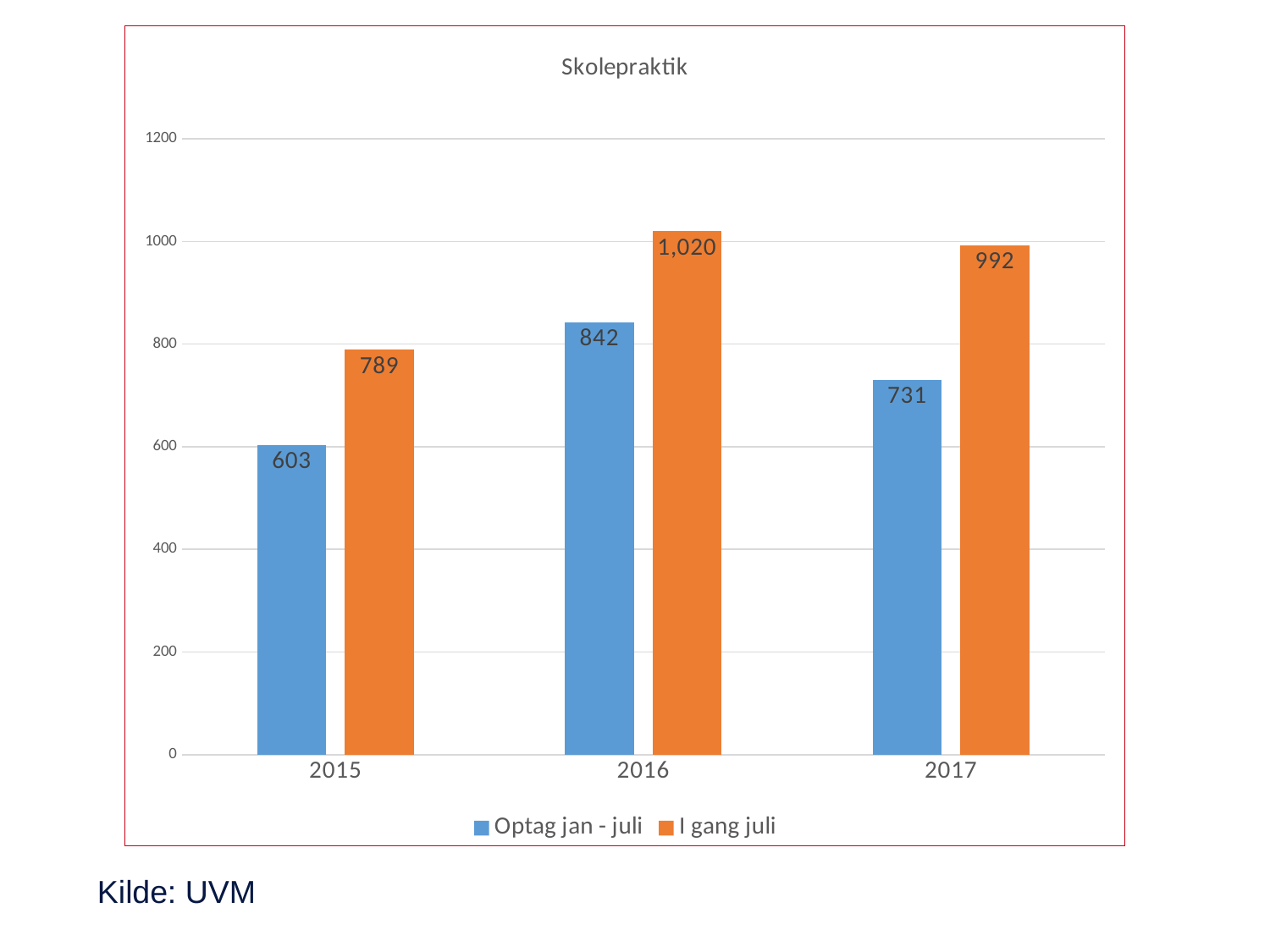
What is the value for "I gang juli" in 2017? 992 Which year has the lowest value for "I gang juli"? 2015 How many years are shown on the x axis? 3 What is the value for "Optag jan - juli" in 2015? 603 Which is larger in 2015: "Optag jan - juli" or "I gang juli"? I gang juli What is the title of the chart? Skolepraktik Is the value for "Optag jan - juli" in 2017 greater or less than 800? less Which year has the highest value for "Optag jan - juli"? 2016 What kind of chart is shown? bar chart What is the value for "I gang juli" in 2016? 1,020 How many series does the legend list? 2 What is the difference between "I gang juli" and "Optag jan - juli" in 2017? 261